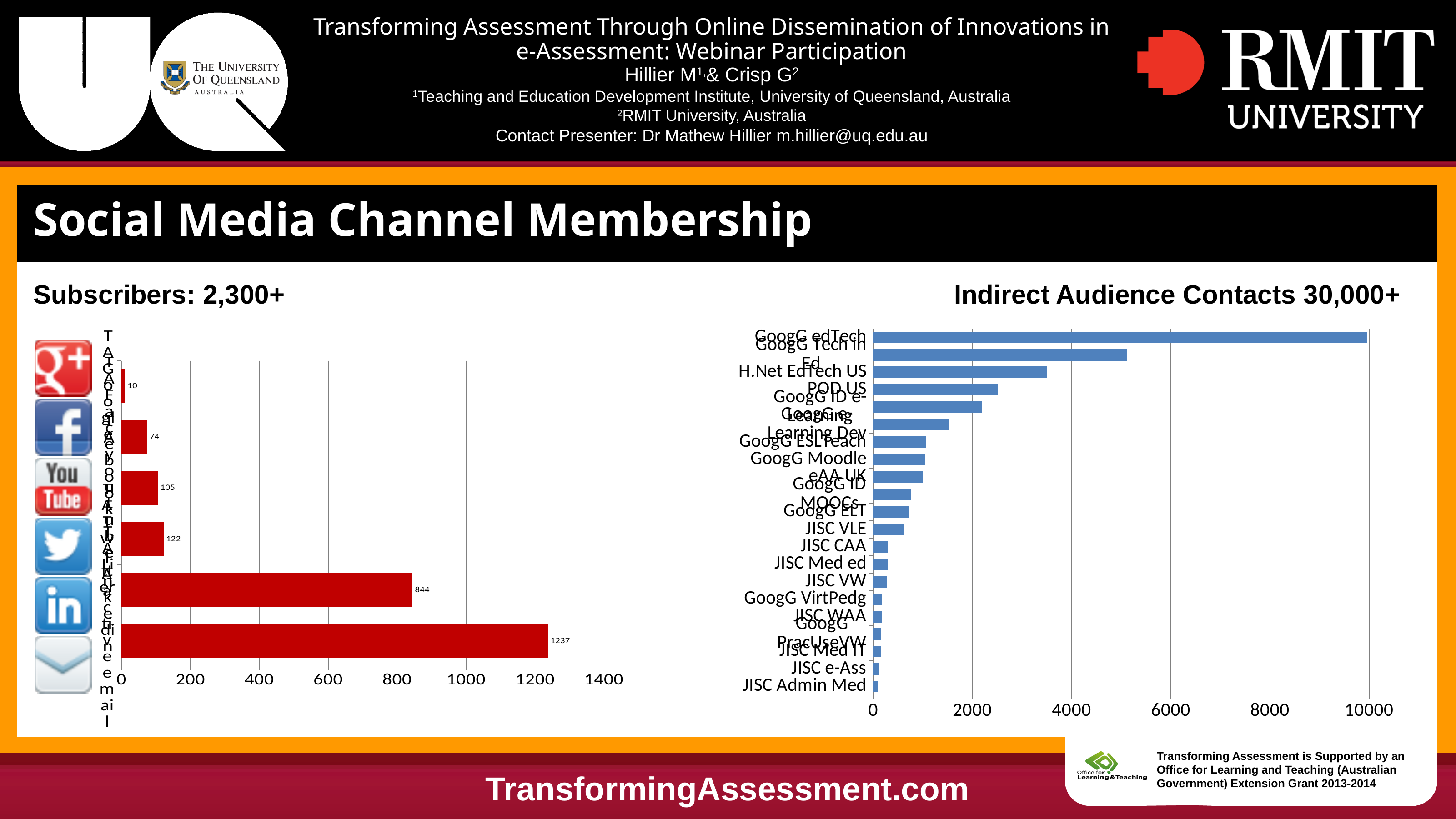
In the 'Indirect Audience Contacts 30,000+' chart on the right, which is larger: H.Net EdTech US or POD US? H.Net EdTech US In the 'Subscribers: 2,300+' chart on the left, what is the value of the longest (bottom) bar? 1237 In the 'Indirect Audience Contacts 30,000+' chart on the right, is the value for JISC VLE greater or less than 2000? less In the 'Subscribers: 2,300+' chart on the left, what is the value of the second bar from the bottom? 844 In the 'Subscribers: 2,300+' chart on the left, what is the value of the shortest (top) bar? 10 In the 'Subscribers: 2,300+' chart on the left, which is larger: the bar labelled 105 or the bar labelled 122? 122 How many bars are plotted in the 'Subscribers: 2,300+' chart on the left? 6 In the 'Subscribers: 2,300+' chart on the left, what is the difference between the two longest bars (1237 and 844)? 393 In the 'Indirect Audience Contacts 30,000+' chart on the right, is the value for GoogG edTech greater or less than 8000? greater What kind of chart is the 'Subscribers: 2,300+' chart on the left? bar chart What colour are the bars in the 'Indirect Audience Contacts 30,000+' chart on the right? blue In the 'Indirect Audience Contacts 30,000+' chart on the right, which category has the highest value? GoogG edTech